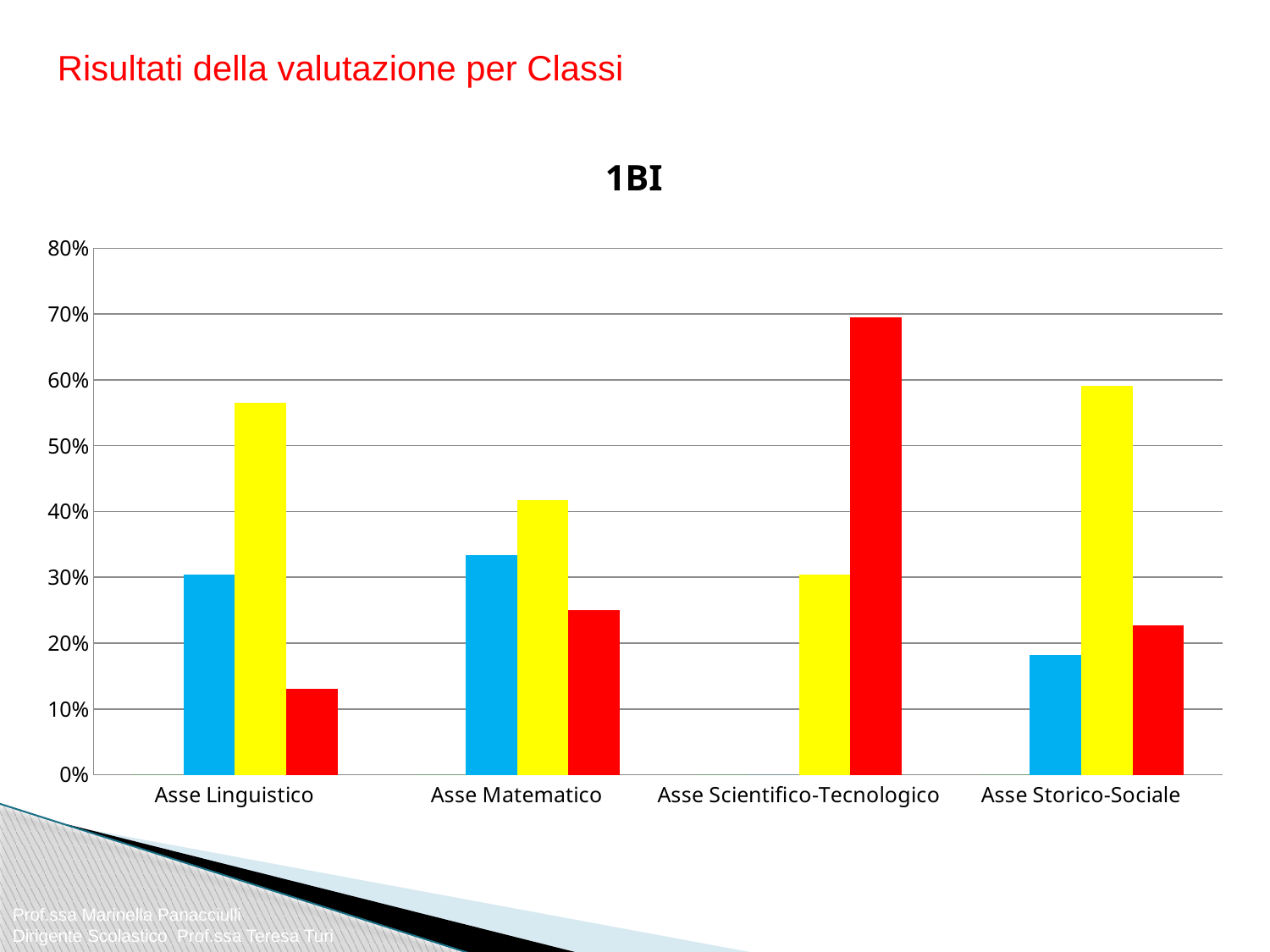
Is the value of the red bar for Asse Matematico greater or less than 30%? less Which category has no blue bar in the chart? Asse Scientifico-Tecnologico Is the value of the yellow bar for Asse Linguistico greater or less than 50%? greater What kind of chart is shown on the slide? bar chart Is the value of the yellow bar for Asse Matematico greater or less than 40%? greater How many categories are shown on the x axis of the chart? 4 Which is larger: the red bar for Asse Scientifico-Tecnologico or the yellow bar for Asse Linguistico? the red bar for Asse Scientifico-Tecnologico What is the title of the chart? 1BI Which category contains the tallest bar in the chart? Asse Scientifico-Tecnologico